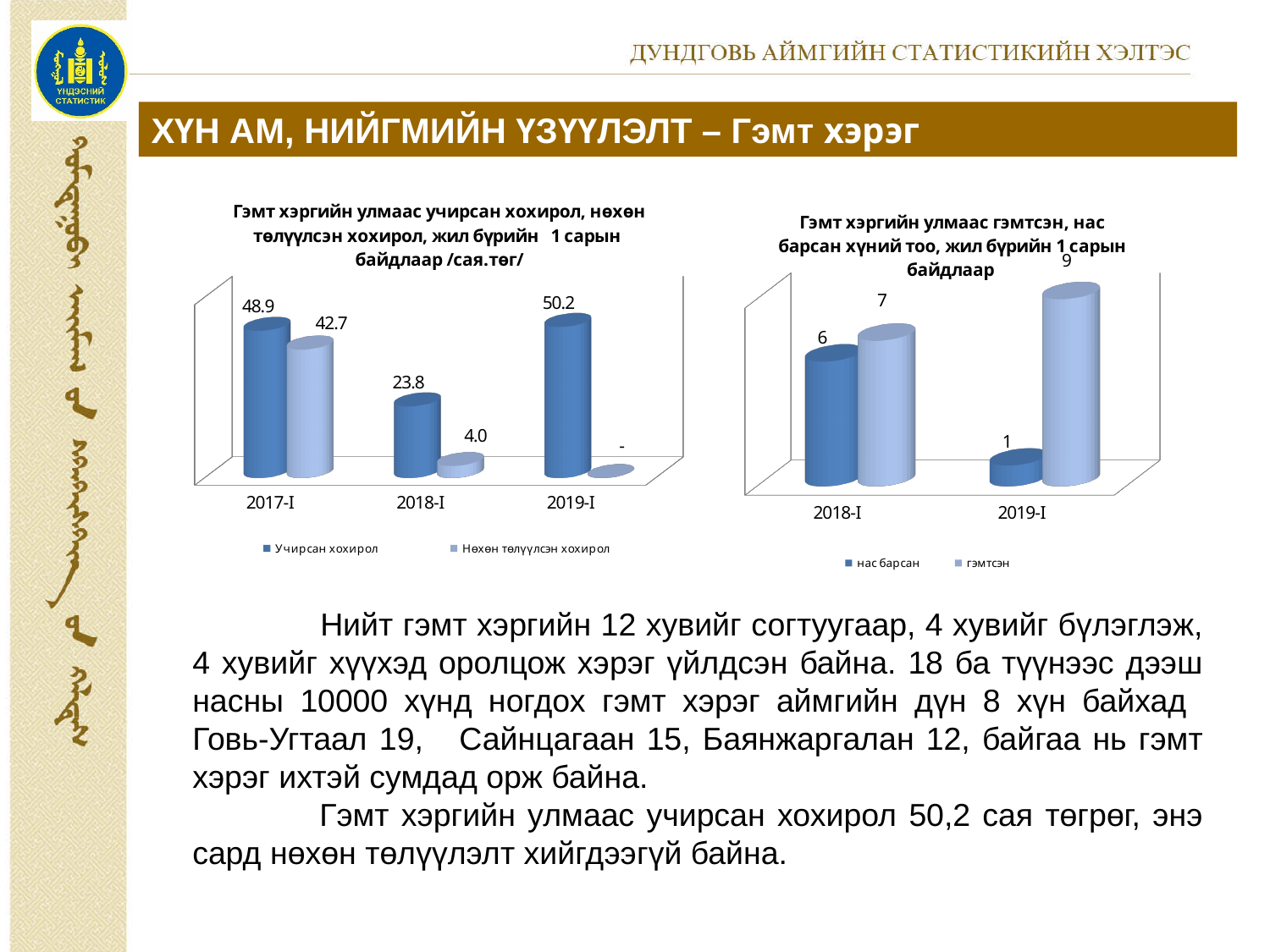
In the left chart, what is the value of Нөхөн төлүүлсэн хохирол for 2017-I? 42.7 In the right chart, how many periods are shown on the x axis? 2 In the left chart, which period has the highest value for Учирсан хохирол? 2019-I In the right chart, what is the value of нас барсан for 2018-I? 6 In the right chart, which is larger for 2019-I: нас барсан or гэмтсэн? гэмтсэн In the left chart, what is the value of Нөхөн төлүүлсэн хохирол for 2018-I? 4.0 What type of chart is the right chart? Bar chart In the left chart, which period has the lowest value for Учирсан хохирол? 2018-I In the left chart, what is the difference between Учирсан хохирол and Нөхөн төлүүлсэн хохирол for 2018-I? 19.8 In the left chart, how many series does the legend list? 2 In the right chart, what is the value of гэмтсэн for 2019-I? 9 In the left chart, what is the value of Учирсан хохирол for 2019-I? 50.2